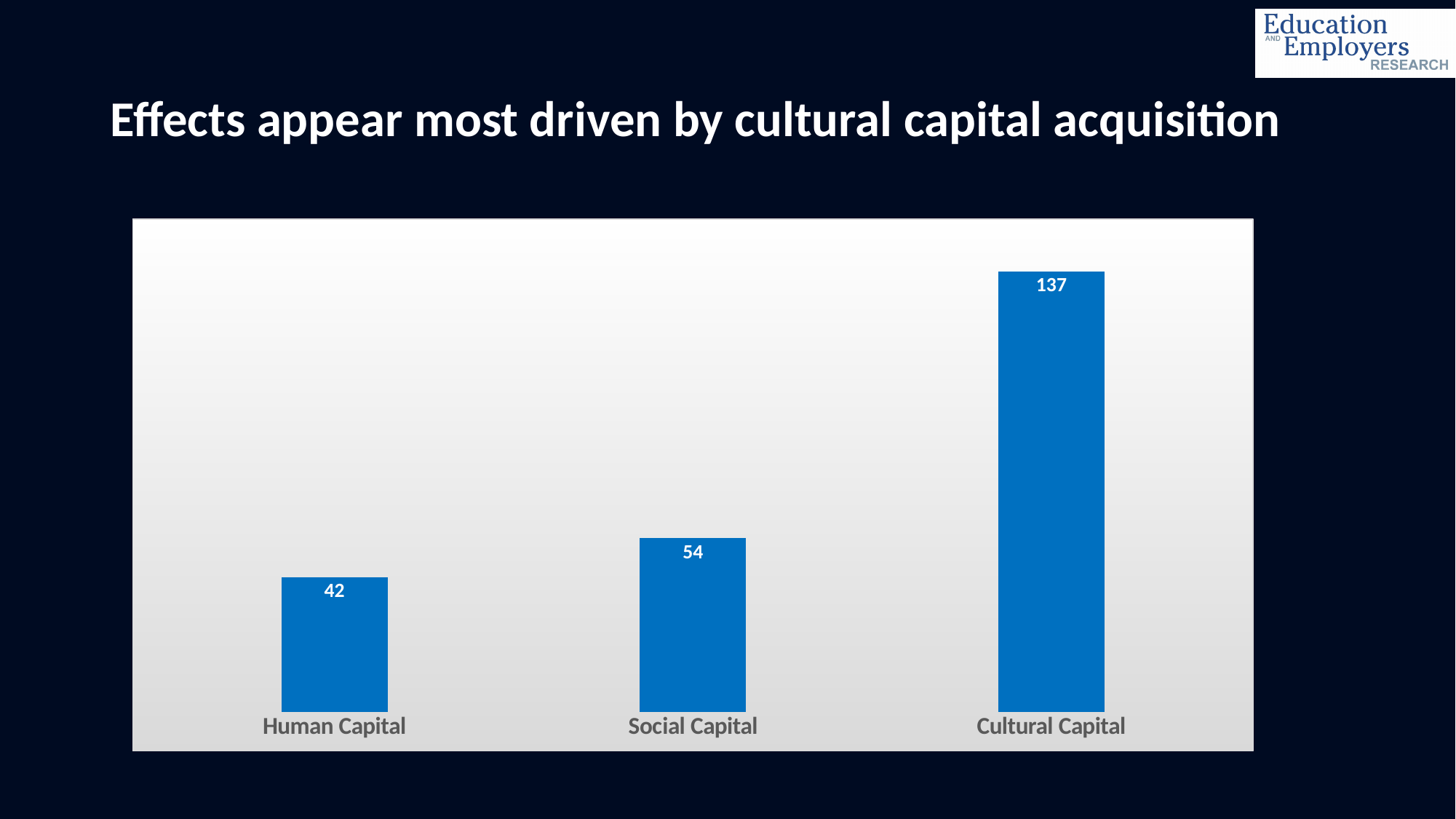
What is the difference between the values for Cultural Capital and Social Capital? 83 Which is larger, the value for Social Capital or the value for Human Capital? Social Capital Which category has the lowest value? Human Capital How many categories are shown in the chart? 3 Do the values rise or fall from left to right across the categories? Rise Which category has the highest value? Cultural Capital What is the value for Cultural Capital? 137 What is the value for Social Capital? 54 What is the difference between the values for Social Capital and Human Capital? 12 What is the title of the slide? Effects appear most driven by cultural capital acquisition What is the value for Human Capital? 42 What kind of chart is shown on the slide? Bar chart